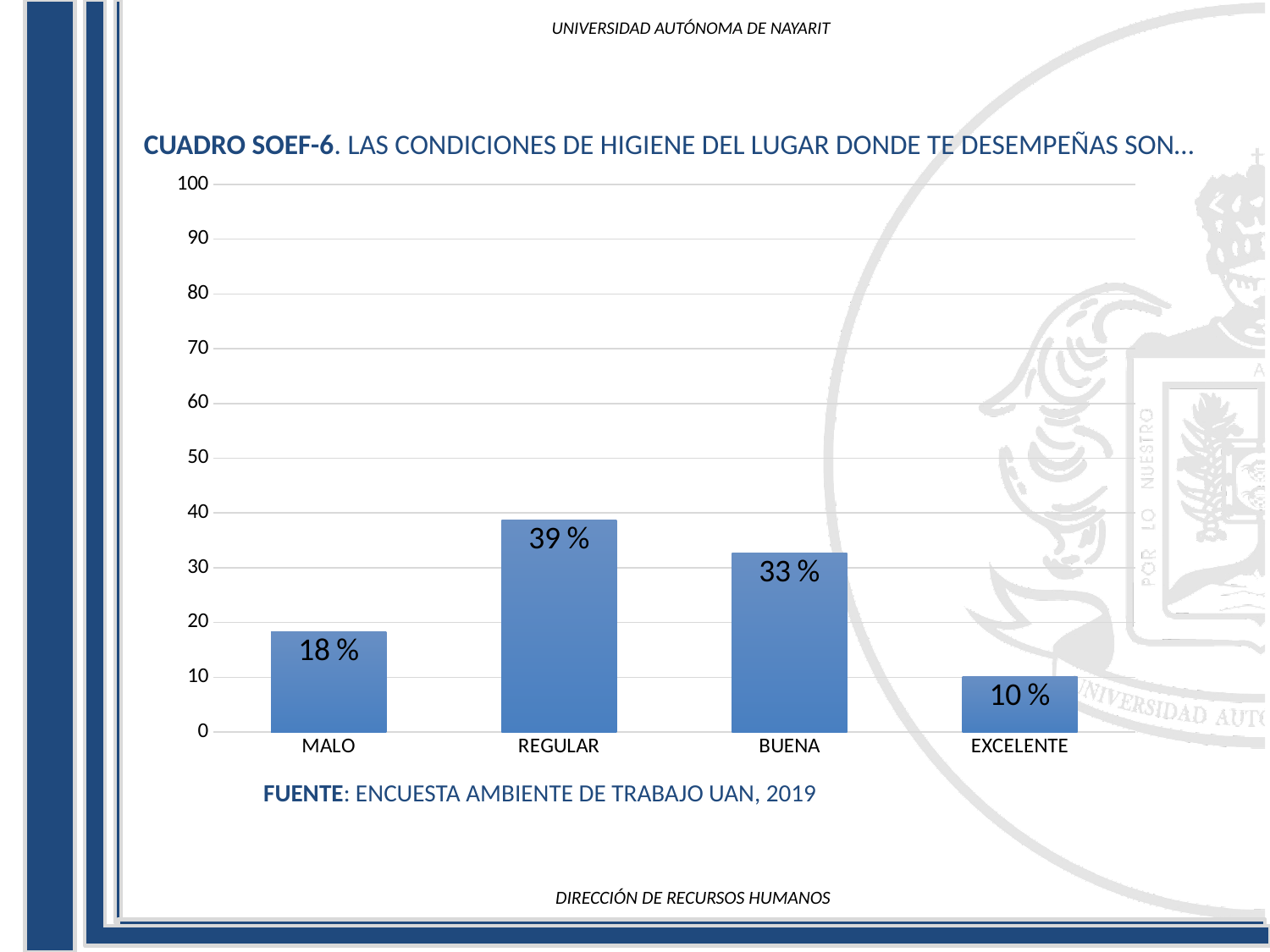
How many categories are shown on the x axis? 4 What is the value for MALO? 18 % Which category has the highest value? REGULAR What source is cited below the chart? ENCUESTA AMBIENTE DE TRABAJO UAN, 2019 What is the value for BUENA? 33 % What is the value for EXCELENTE? 10 % What is the difference between the values for REGULAR and BUENA? 6 % Is the value for BUENA greater or less than 40? less Which is larger, the value for MALO or the value for EXCELENTE? MALO What kind of chart is shown on the slide? bar chart What is the value for REGULAR? 39 % Which category has the lowest value? EXCELENTE